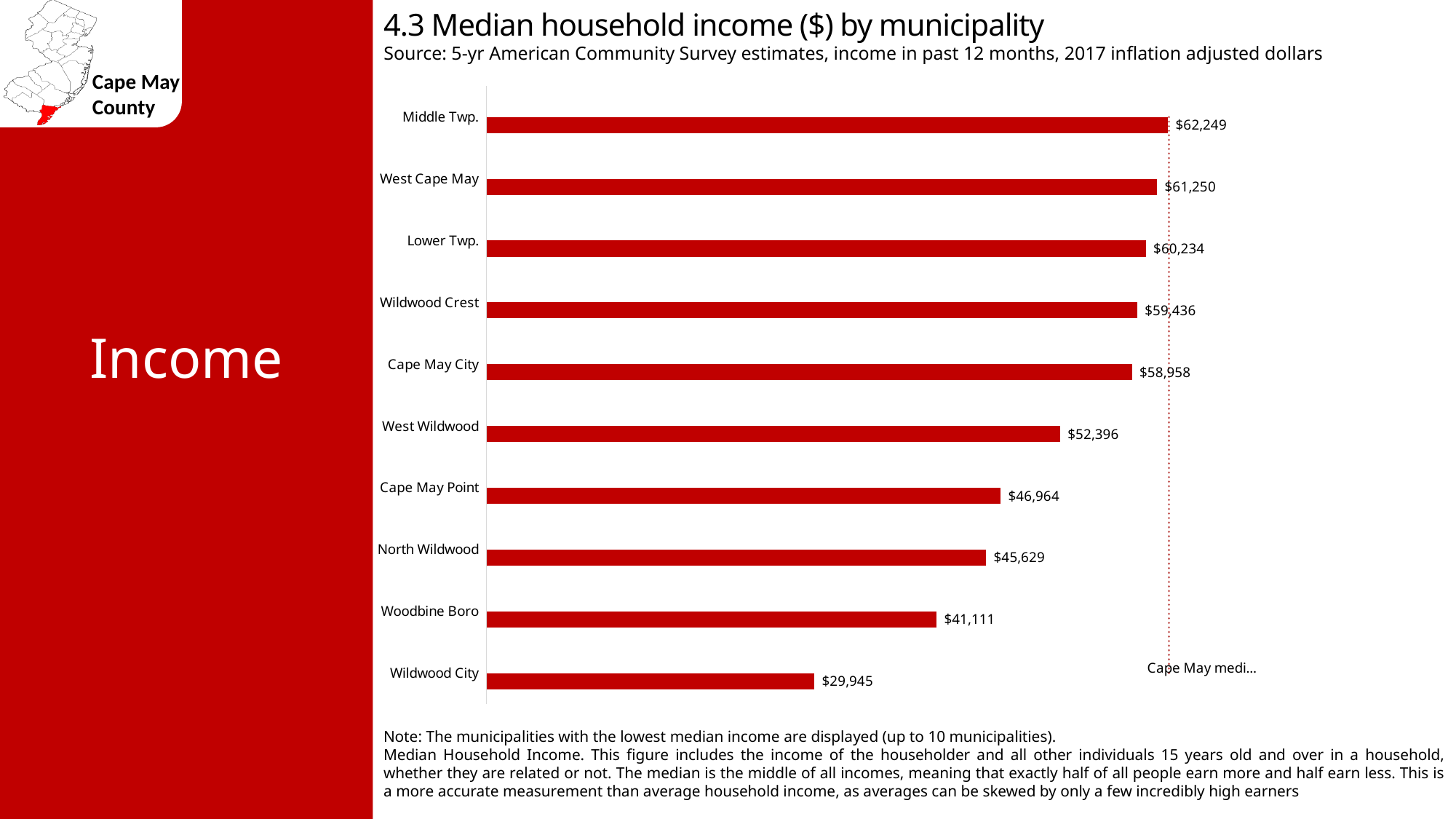
What is the median household income for Wildwood City? $29,945 How many municipalities are shown on the chart? 10 What kind of chart is used to show median household income by municipality? Bar chart Which municipality has the highest median household income shown on the chart? Middle Twp. Which has a higher median household income, Woodbine Boro or West Wildwood? West Wildwood What is the median household income for Cape May Point? $46,964 What is the median household income for West Wildwood? $52,396 What is the difference in median household income between Cape May Point and North Wildwood? $1,335 What is the difference in median household income between Middle Twp. and Wildwood City? $32,304 What colour are the bars on the chart? Red Which municipality has the lowest median household income shown on the chart? Wildwood City What is the median household income for Middle Twp.? $62,249